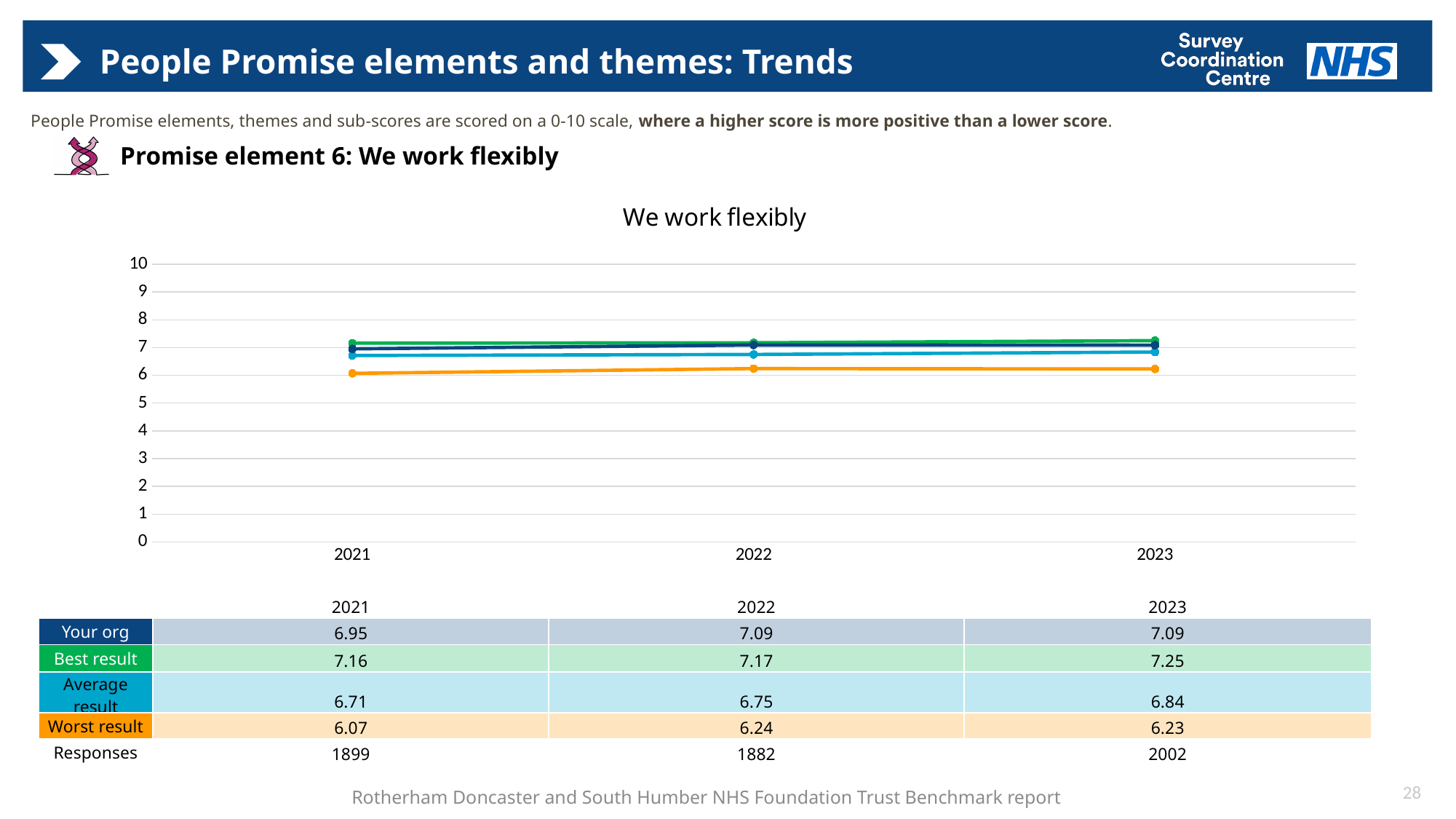
What is the Average result value in 2023 on the We work flexibly chart? 6.84 What is the Worst result value in 2022 on the We work flexibly chart? 6.24 What is the difference between the Best result and Your org in 2023 on the We work flexibly chart? 0.16 Is the Worst result value for 2021 greater or less than 7 on the We work flexibly chart? less What type of chart is the We work flexibly chart? line chart In which year is the Worst result lowest on the We work flexibly chart? 2021 Which is larger in 2022 on the We work flexibly chart: Your org or Average result? Your org What is the Best result value in 2023 on the We work flexibly chart? 7.25 What is the value for Your org in 2021 on the We work flexibly chart? 6.95 In which year is the Best result highest on the We work flexibly chart? 2023 How many years are shown on the x axis of the We work flexibly chart? 3 How many series are plotted on the We work flexibly chart? 4